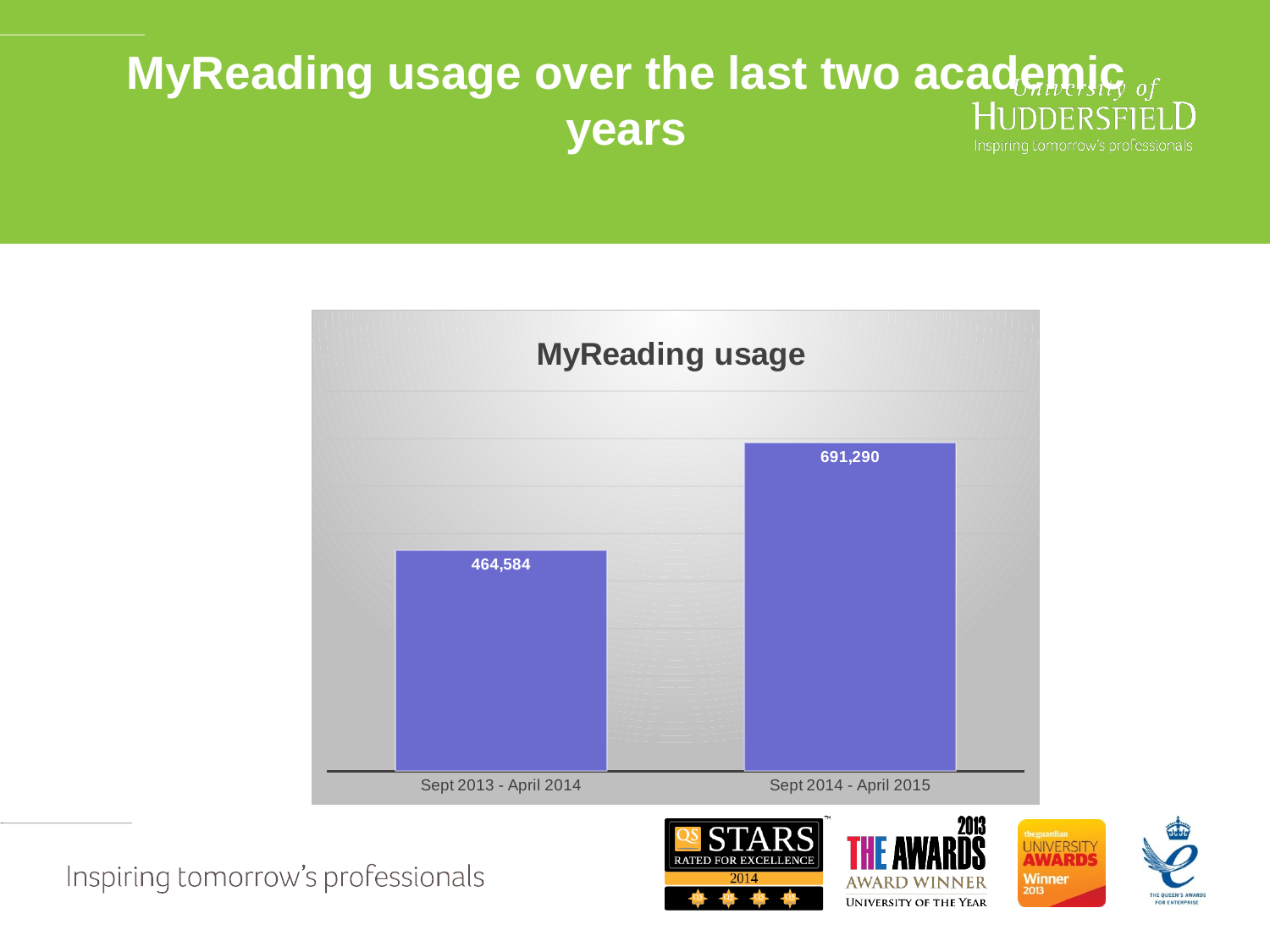
What is the MyReading usage value for Sept 2013 - April 2014? 464,584 Which period has the highest MyReading usage? Sept 2014 - April 2015 How many periods (bars) are shown in the chart? 2 What is the MyReading usage value for Sept 2014 - April 2015? 691,290 Does MyReading usage rise or fall from Sept 2013 - April 2014 to Sept 2014 - April 2015? Rise What colour are the bars in the chart? Purple Which is larger: MyReading usage for Sept 2013 - April 2014 or for Sept 2014 - April 2015? Sept 2014 - April 2015 Which period has the lowest MyReading usage? Sept 2013 - April 2014 What is the title of the chart? MyReading usage What kind of chart is shown on the slide? Bar chart What is the difference in MyReading usage between Sept 2014 - April 2015 and Sept 2013 - April 2014? 226,706